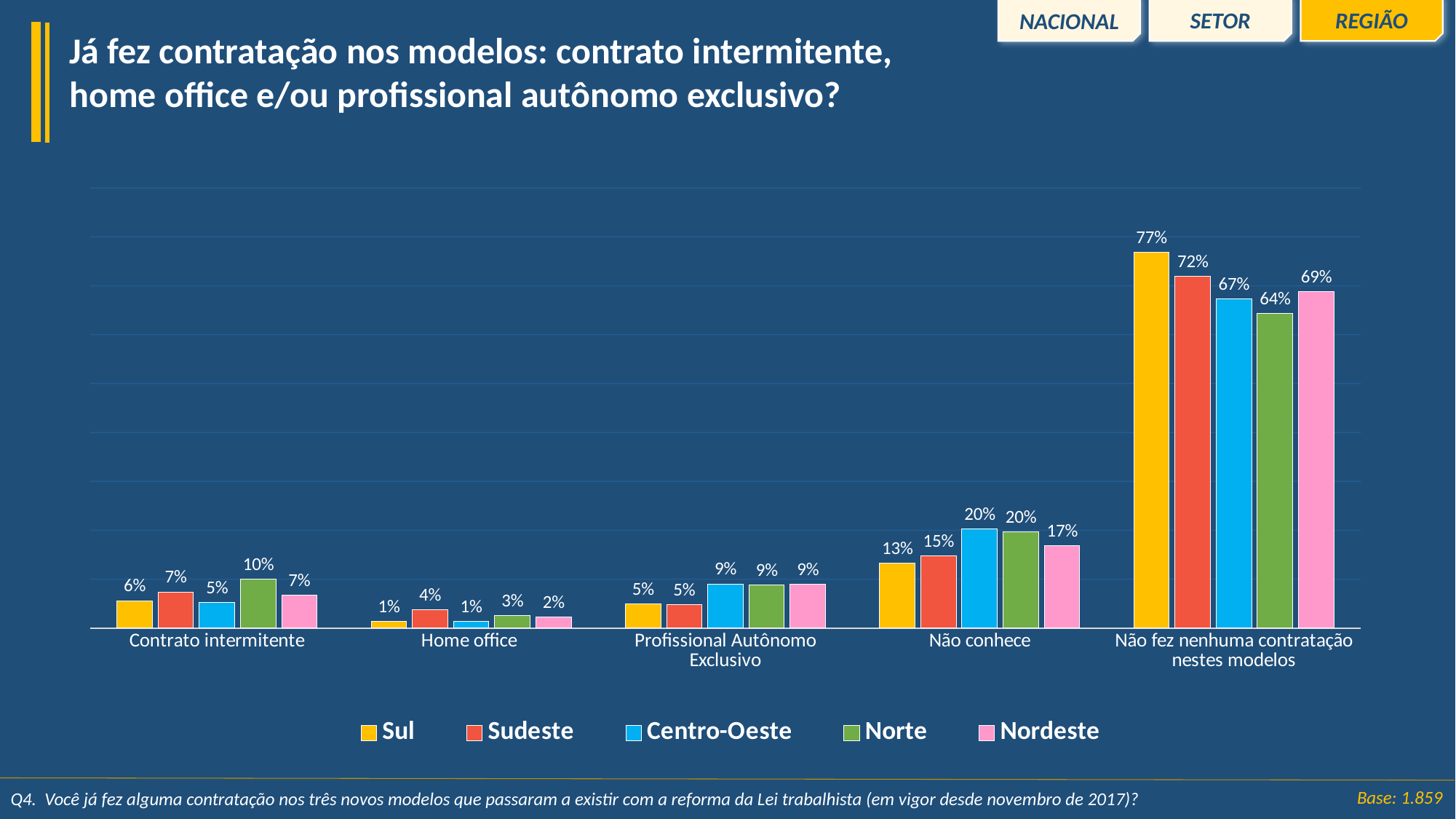
What is the value for Centro-Oeste in the Profissional Autônomo Exclusivo category? 9% In the Não conhece category, which is larger: the value for Sudeste or the value for Sul? Sudeste How many categories are shown on the x axis? 5 What kind of chart is shown on the slide? Bar chart What is the value for Nordeste in the Não conhece category? 17% What is the value for Sudeste in the Home office category? 4% What is the difference between the Sul and Norte values in the Não fez nenhuma contratação nestes modelos category? 13% Which region has the highest value in the Não fez nenhuma contratação nestes modelos category? Sul Which colour represents the Centro-Oeste series in the legend? Blue What is the value for Norte in the Contrato intermitente category? 10% Which region has the lowest value in the Não fez nenhuma contratação nestes modelos category? Norte How many series does the legend list? 5